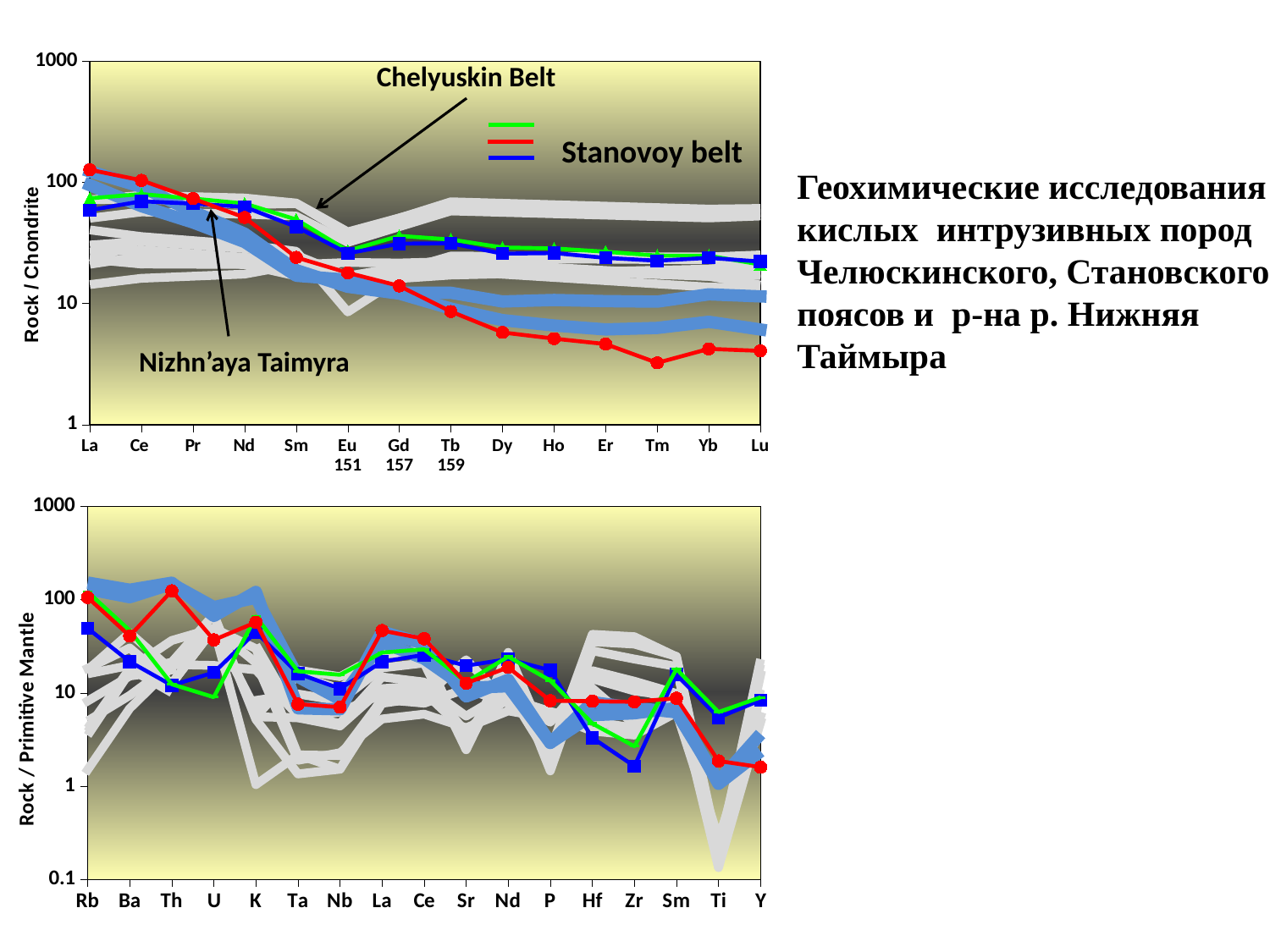
In the bottom chart (Rock / Primitive Mantle), is the value of the red line at Th greater or less than 100? greater In the top chart (Rock / Chondrite), which line is higher at Tm, the green line or the red line? green line What kind of chart is the top chart (Rock / Chondrite)? line chart How many categories are on the x axis of the top chart (Rock / Chondrite)? 14 In the top chart (Rock / Chondrite), does the red line rise or fall from La to Lu? fall What is the y-axis label of the bottom chart? Rock / Primitive Mantle In the bottom chart (Rock / Primitive Mantle), is the value of the blue line at Zr greater or less than 10? less In the top chart (Rock / Chondrite), is the value of the red line at Tm greater or less than 10? less How many categories are on the x axis of the bottom chart (Rock / Primitive Mantle)? 17